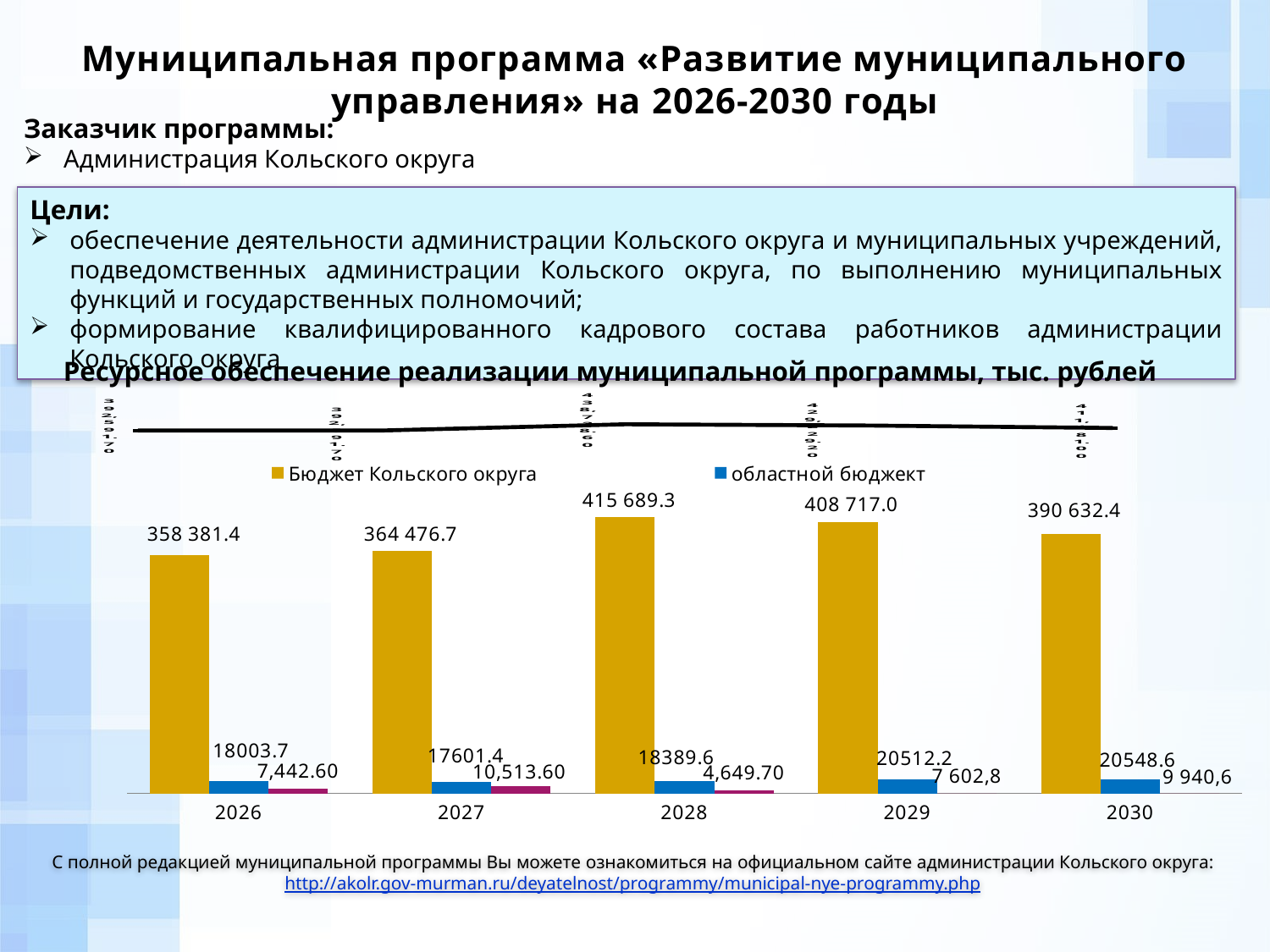
What kind of chart is shown on the slide? bar chart In which year is the Бюджет Кольского округа value highest? 2028 What is the value for областной бюджект in 2029? 20512.2 Which is larger: the Бюджет Кольского округа value for 2029 or for 2030? 2029 What is the difference between the Бюджет Кольского округа values for 2028 and 2026? 57 307.9 In which year is the областной бюджект value lowest? 2027 What is the value for Бюджет Кольского округа in 2028? 415 689.3 How many series does the chart legend list? 2 What is the value for Бюджет Кольского округа in 2030? 390 632.4 In which year is the Бюджет Кольского округа value lowest? 2026 How many years are shown on the x axis of the chart? 5 What is the value for областной бюджект in 2026? 18003.7